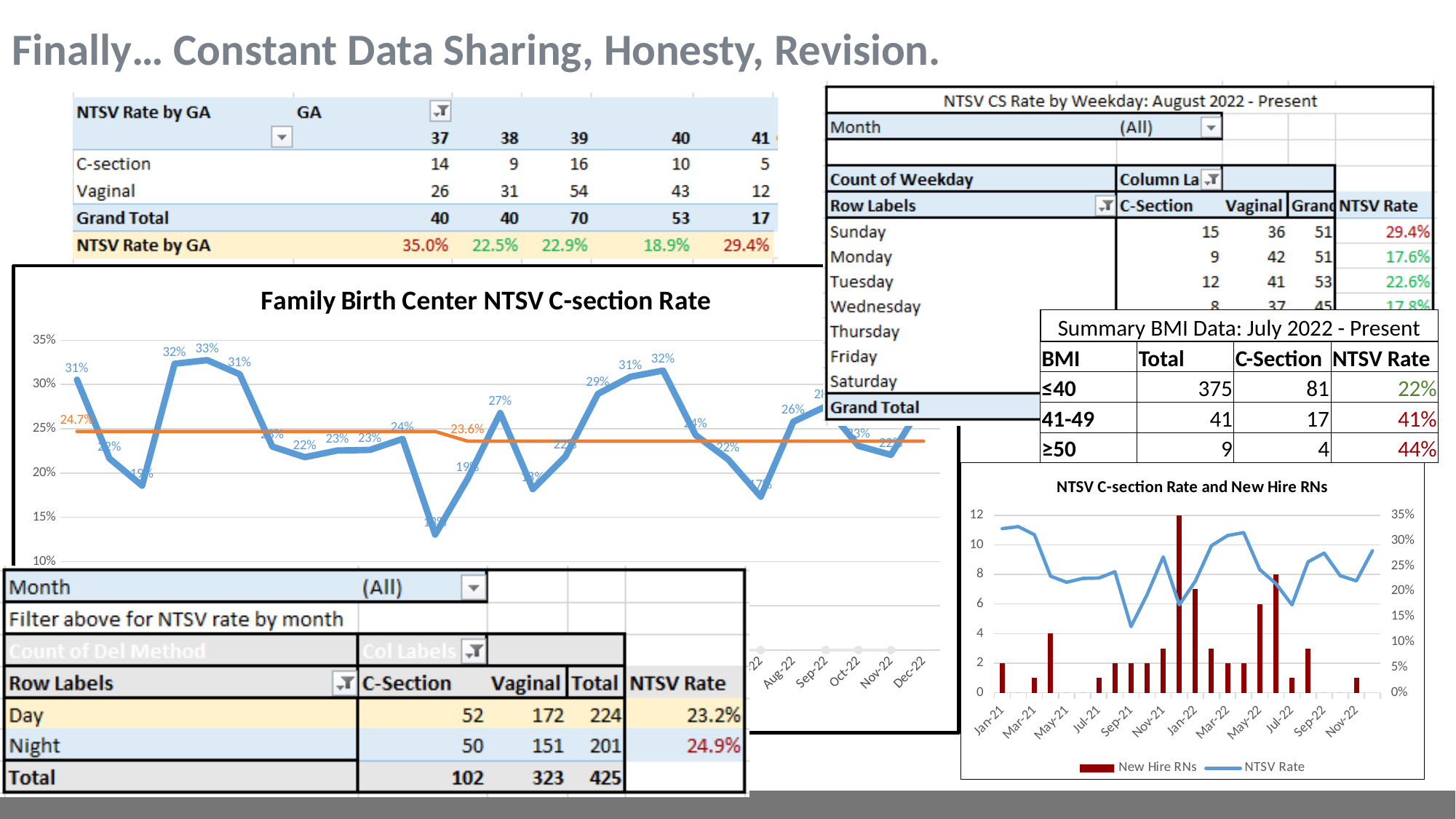
In the 'Family Birth Center NTSV C-section Rate' chart, what is the highest labeled value on the blue line? 33% In the 'Family Birth Center NTSV C-section Rate' chart, what is the highest value shown on the y-axis? 35% In the 'Family Birth Center NTSV C-section Rate' chart, what is the second value labeled on the orange line? 23.6% In the 'Family Birth Center NTSV C-section Rate' chart, what is the first value labeled on the orange line? 24.7% In the 'NTSV C-section Rate and New Hire RNs' chart, which month has the tallest New Hire RNs bar? Dec-21 In the 'NTSV C-section Rate and New Hire RNs' chart, is the New Hire RNs value for Jan-22 greater or less than 10? less In the 'NTSV C-section Rate and New Hire RNs' chart, is the NTSV Rate for Jan-21 greater or less than 25%? greater In the 'Family Birth Center NTSV C-section Rate' chart, what is the lowest labeled value on the blue line? 13% How many series does the legend of the 'NTSV C-section Rate and New Hire RNs' chart list? 2 In the 'Family Birth Center NTSV C-section Rate' chart, what is the difference between the highest labeled value (33%) and the lowest labeled value (13%)? 20 percentage points In the 'NTSV C-section Rate and New Hire RNs' chart, which series is drawn as bars? New Hire RNs What type of chart is the 'Family Birth Center NTSV C-section Rate' chart? line chart